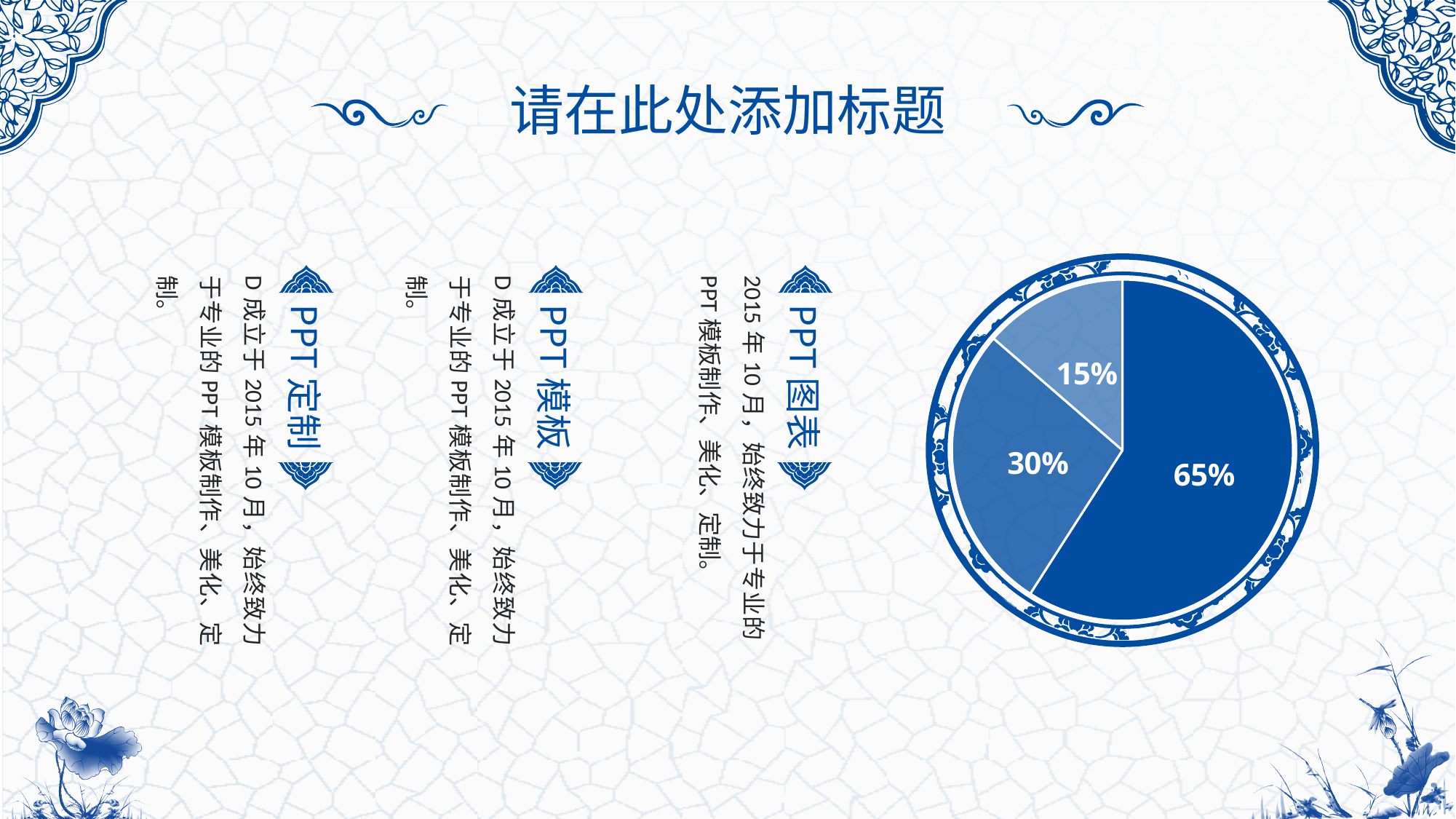
What is the difference between the 65% slice and the 30% slice on the pie chart? 35% What is the largest value labelled on the pie chart? 65% Which slice is larger on the pie chart, the medium blue slice or the lightest blue slice? the medium blue slice Does the pie chart have a legend? No What value is labelled on the lightest blue slice of the pie chart? 15% What is the smallest value labelled on the pie chart? 15% How many slices does the pie chart have? 3 What kind of chart is shown on the slide? pie chart What value is labelled on the darkest blue slice of the pie chart? 65% What colour are the data labels on the pie chart? white What is the difference between the largest and smallest slice values on the pie chart? 50% What value is labelled on the medium blue slice of the pie chart? 30%